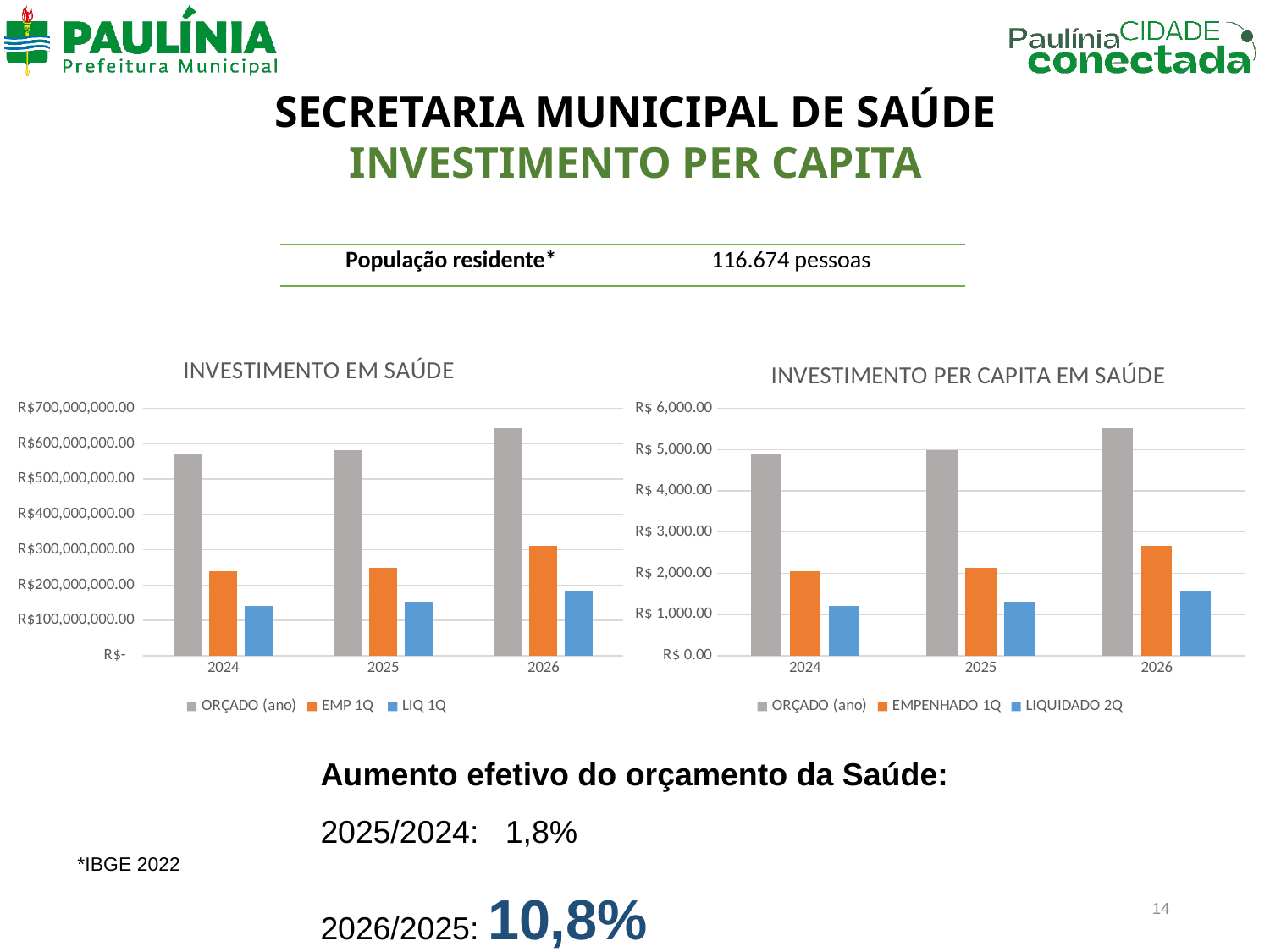
How many series does the legend of the INVESTIMENTO EM SAÚDE chart list? 3 In the INVESTIMENTO PER CAPITA EM SAÚDE chart, which series is shown in blue? LIQUIDADO 2Q In the INVESTIMENTO EM SAÚDE chart, which year has the highest ORÇADO (ano) bar? 2026 In the INVESTIMENTO EM SAÚDE chart, which series has the lowest bar in every year? LIQ 1Q In the INVESTIMENTO EM SAÚDE chart, is the ORÇADO (ano) value for 2024 greater or less than R$600,000,000.00? less In the INVESTIMENTO EM SAÚDE chart, is the EMP 1Q value for 2024 greater or less than R$200,000,000.00? greater In the INVESTIMENTO PER CAPITA EM SAÚDE chart, do the ORÇADO (ano) values rise or fall from 2024 to 2026? rise In the INVESTIMENTO EM SAÚDE chart, is the ORÇADO (ano) value for 2026 greater or less than R$600,000,000.00? greater What kind of chart is the INVESTIMENTO PER CAPITA EM SAÚDE chart? bar chart How many years are shown on the x axis of the INVESTIMENTO PER CAPITA EM SAÚDE chart? 3